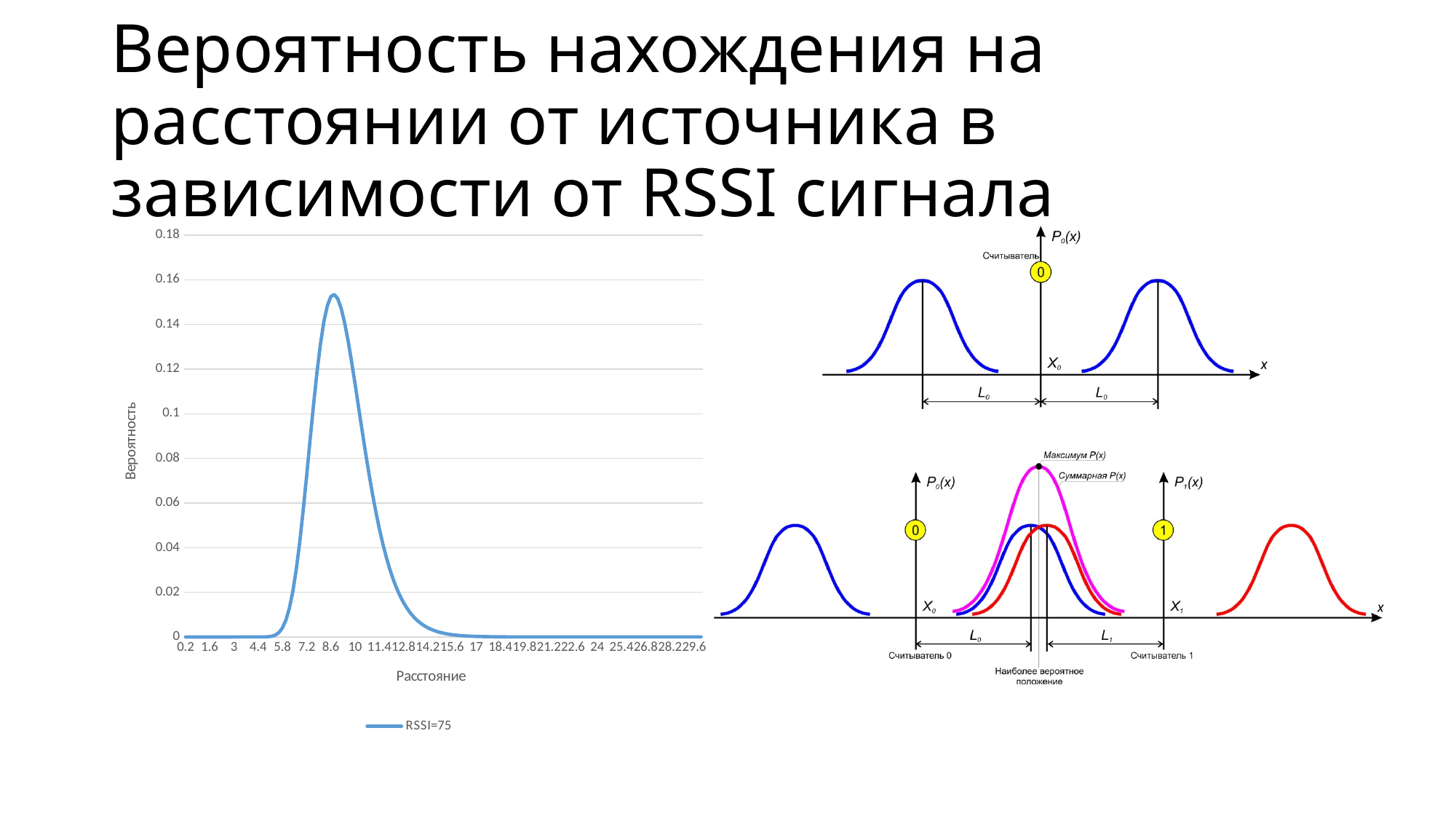
What kind of chart is shown on the left of the slide? line chart In the left chart, at which x-axis tick does the RSSI=75 line reach its highest value? 8.6 In the left chart, is the peak value of the RSSI=75 line greater or less than 0.16? less In the left chart, does the RSSI=75 line rise or fall between 5.8 and 8.6 on the x axis? rise In the left chart, does the RSSI=75 line rise or fall between 8.6 and 17 on the x axis? fall In the left chart, is the peak value of the RSSI=75 line greater or less than 0.14? greater In the left chart, is the value of the RSSI=75 line at 5.8 greater or less than 0.02? less What is the legend entry of the left chart? RSSI=75 In the left chart, which is larger: the value of the RSSI=75 line at 8.6 or at 12.8? 8.6 How many series does the legend of the left chart list? 1 What is the title of the vertical axis of the left chart? Вероятность